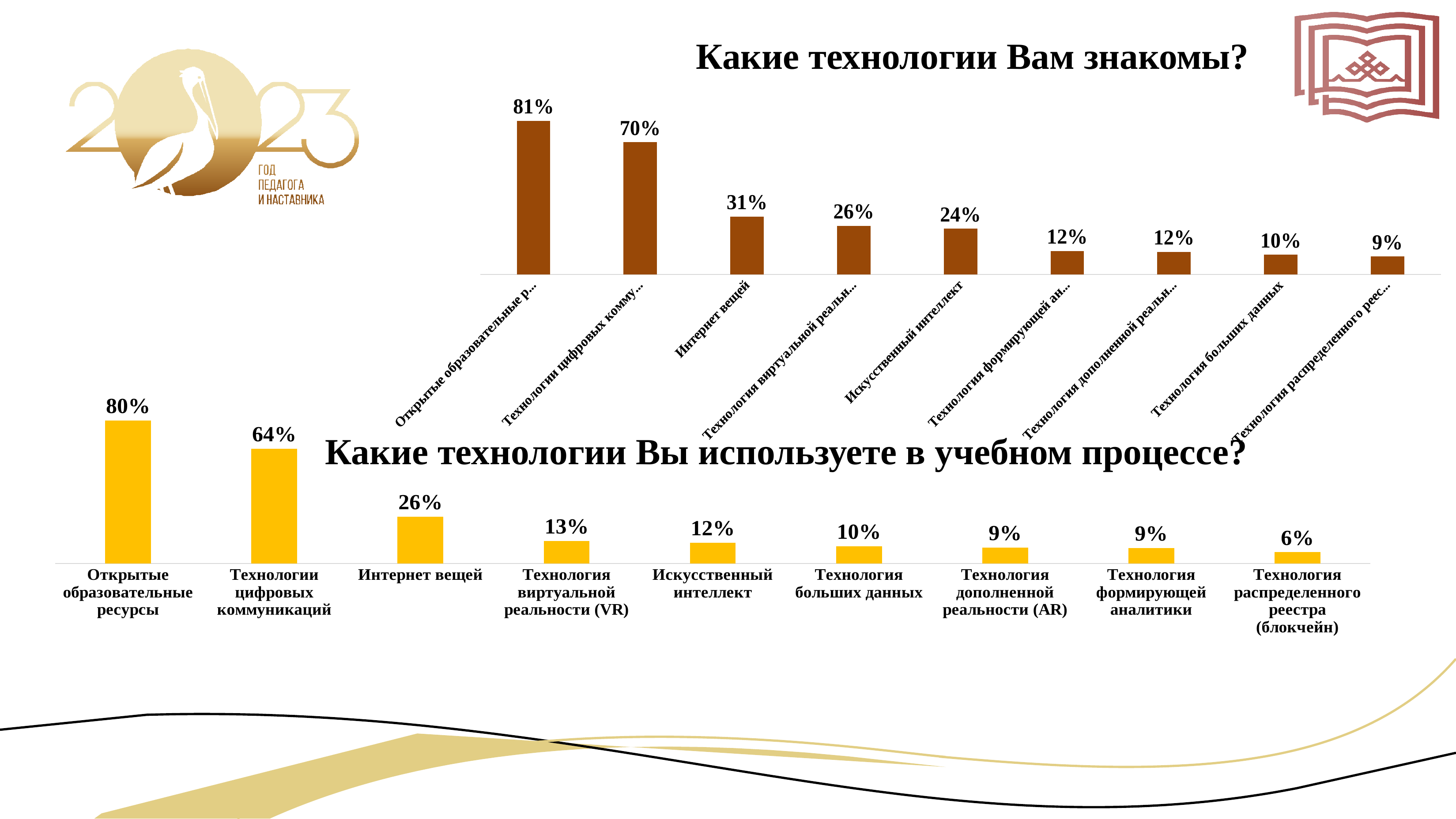
In the chart 'Какие технологии Вам знакомы?', what is the value for Интернет вещей? 31% In the chart 'Какие технологии Вы используете в учебном процессе?', what is the difference between Открытые образовательные ресурсы and Технологии цифровых коммуникаций? 16% In the chart 'Какие технологии Вы используете в учебном процессе?', which category has the highest value? Открытые образовательные ресурсы In the chart 'Какие технологии Вы используете в учебном процессе?', which category has the lowest value? Технология распределенного реестра (блокчейн) In the chart 'Какие технологии Вы используете в учебном процессе?', what is the value for Технология виртуальной реальности (VR)? 13% In the chart 'Какие технологии Вам знакомы?', what is the highest value shown? 81% In the chart 'Какие технологии Вы используете в учебном процессе?', which is larger: Искусственный интеллект or Технология больших данных? Искусственный интеллект In the chart 'Какие технологии Вам знакомы?', how many bars are there? 9 In the chart 'Какие технологии Вам знакомы?', what is the value for Технология больших данных? 10% What type of chart is 'Какие технологии Вы используете в учебном процессе?'? bar chart In the chart 'Какие технологии Вам знакомы?', what is the value for Искусственный интеллект? 24% In the chart 'Какие технологии Вы используете в учебном процессе?', do the values rise or fall from left to right? fall